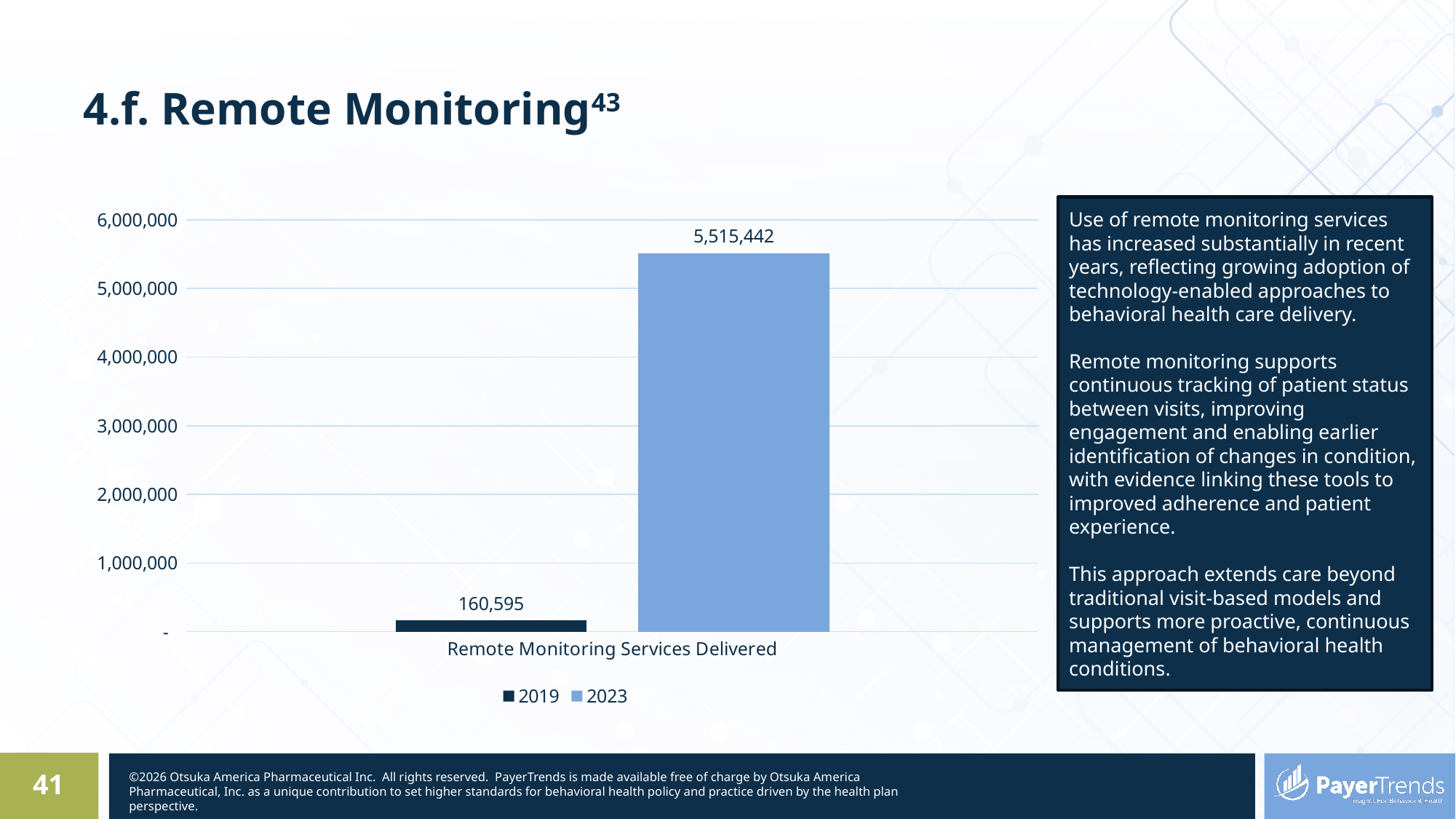
What is the difference between the 2023 and 2019 values? 5,354,847 What is the value for 2023 in the Remote Monitoring Services Delivered chart? 5,515,442 Which series has the higher value, 2019 or 2023? 2023 Which series has the lowest value in the chart? 2019 Do the values rise or fall from 2019 to 2023? Rise Is the value for 2019 greater or less than 1,000,000? less What kind of chart is shown on the slide? Bar chart What is the value for 2019 in the Remote Monitoring Services Delivered chart? 160,595 How many series does the legend list? 2 Is the value for 2023 greater or less than 5,000,000? greater What is the category label shown on the x axis of the chart? Remote Monitoring Services Delivered What is the highest value shown on the y axis of the chart? 6,000,000